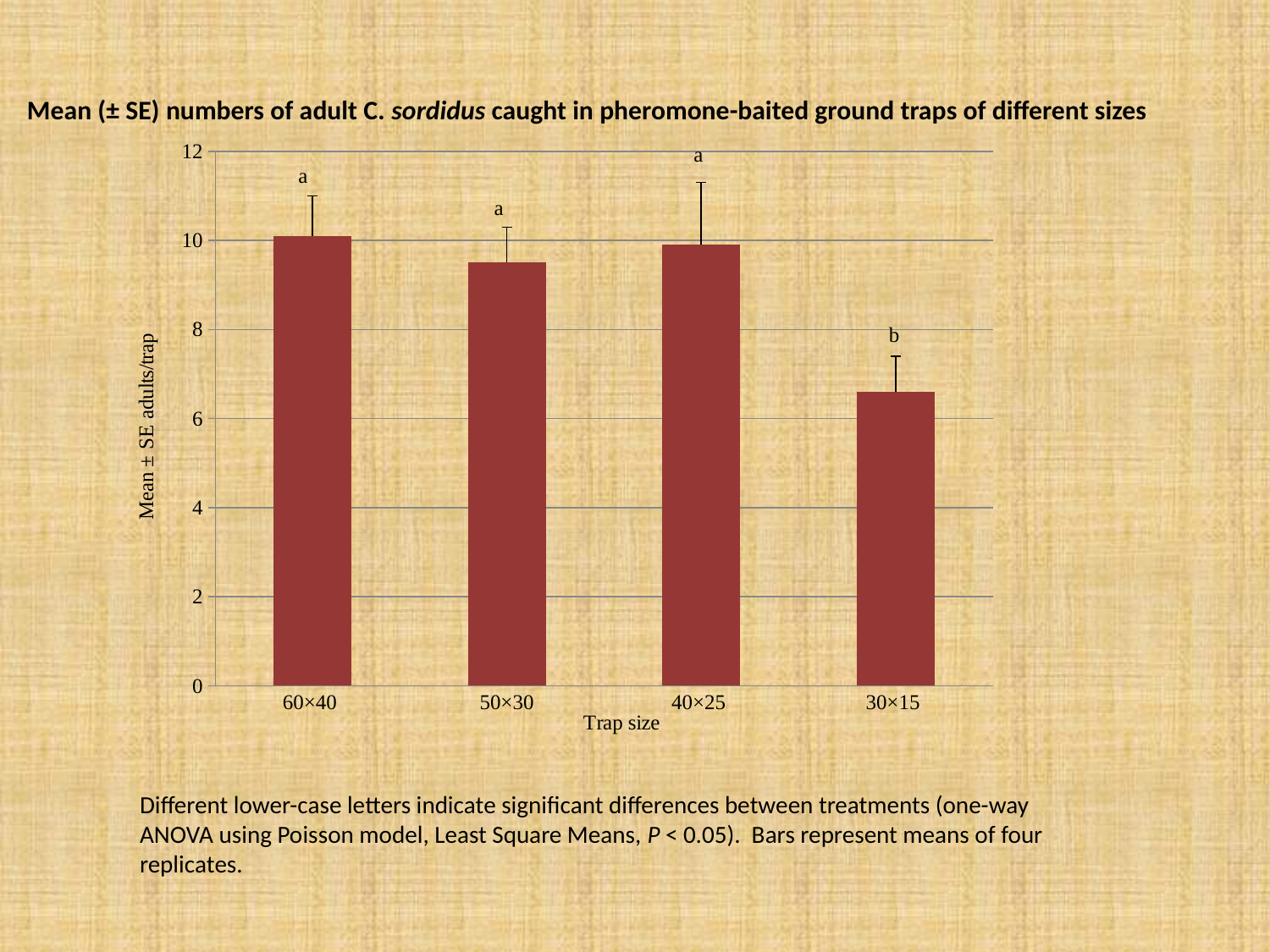
What is the title of the x axis of the chart? Trap size Is the value for the 30×15 trap greater or less than 8? less Is the value for the 50×30 trap greater or less than 10? less Is the value for the 60×40 trap greater or less than 8? greater Which trap size has the lowest mean number of adults per trap? 30×15 Which has the larger mean number of adults per trap, the 60×40 trap or the 30×15 trap? 60×40 What kind of chart is shown on the slide? bar chart Which has the larger mean number of adults per trap, the 50×30 trap or the 30×15 trap? 50×30 Which trap size bar is marked with the letter b? 30×15 How many trap sizes are plotted on the x axis? 4